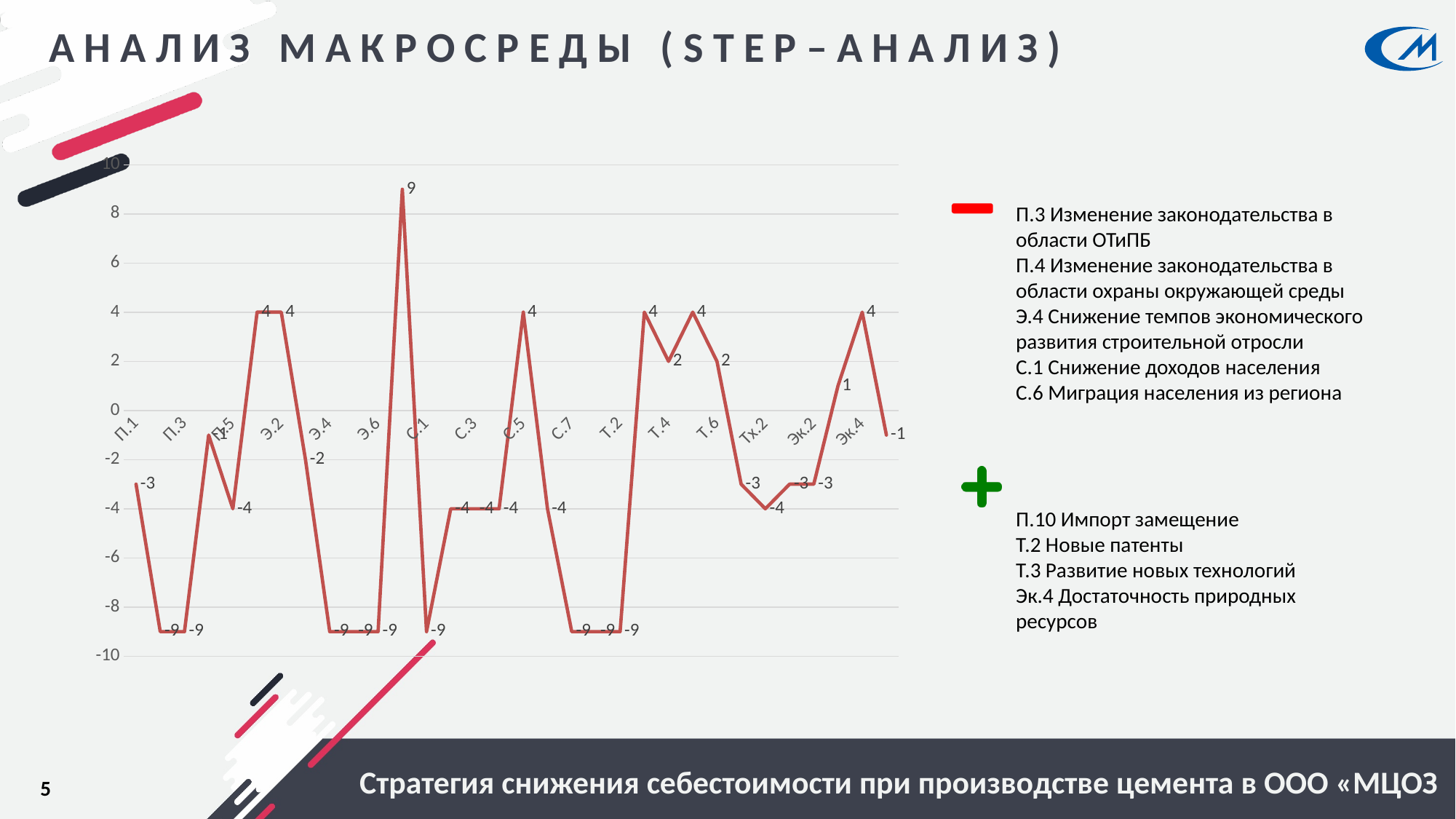
What colour is the line in the chart? red What is the highest value plotted on the line chart? 9 What is the value of the rightmost point on the line chart? -1 Is the leftmost point on the line chart greater or less than 0? less What is the difference between the highest plotted value (9) and the lowest plotted value (-9)? 18 What kind of chart is shown on the slide? line chart How many category labels are shown along the x axis of the chart? 16 Is the rightmost point of the line higher or lower than the leftmost point? higher How many points on the line chart have a value of 9? 1 What is the maximum value shown on the vertical axis of the chart? 10 What is the value of the leftmost point on the line chart? -3 What is the lowest value plotted on the line chart? -9